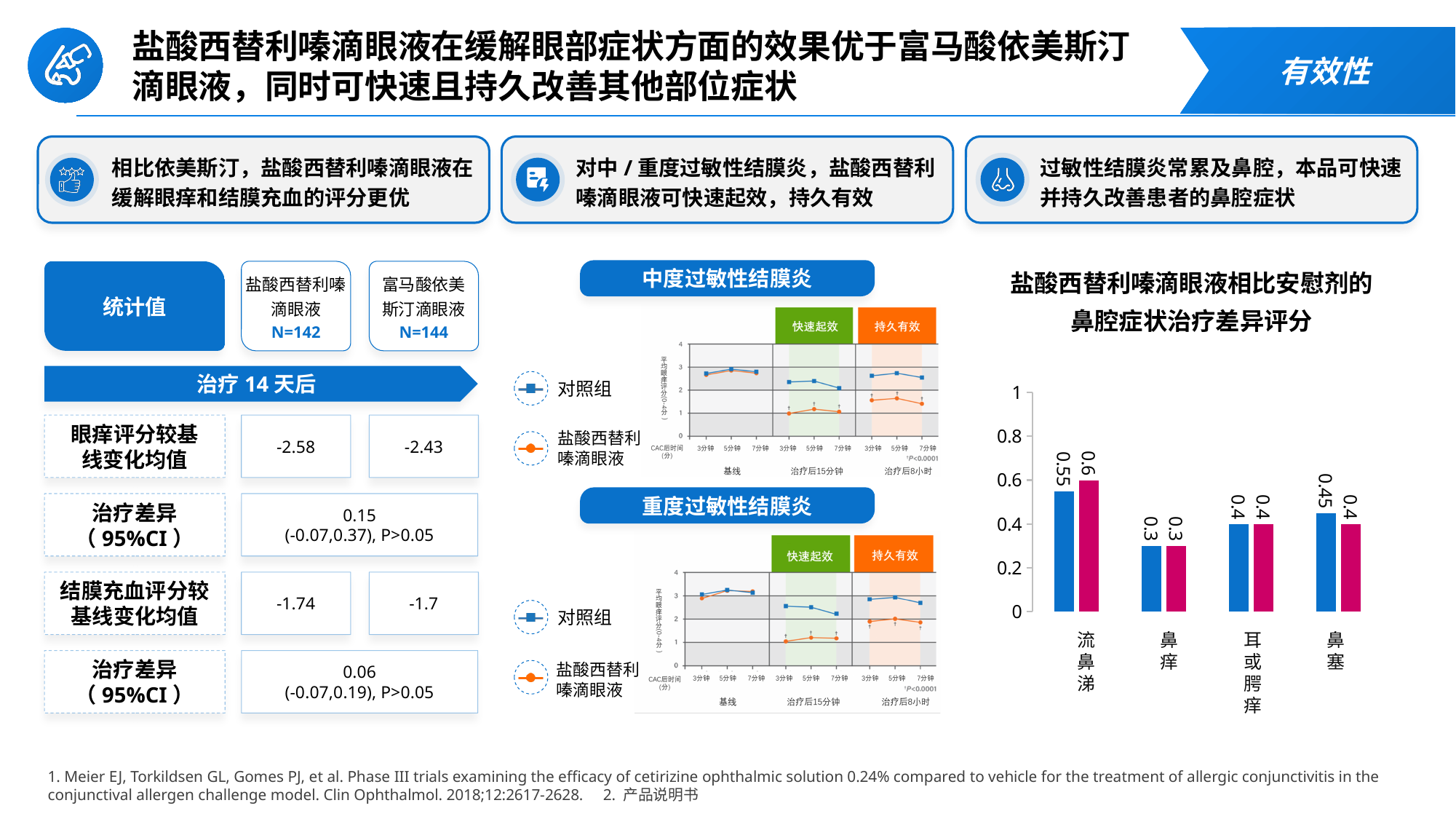
In the bar chart 盐酸西替利嗪滴眼液相比安慰剂的鼻腔症状治疗差异评分, what is the value of the blue bar for 流鼻涕? 0.55 In the bar chart 盐酸西替利嗪滴眼液相比安慰剂的鼻腔症状治疗差异评分, what is the value of the pink bar for 鼻痒? 0.3 In the bar chart 盐酸西替利嗪滴眼液相比安慰剂的鼻腔症状治疗差异评分, which is larger for 鼻塞, the blue bar or the pink bar? the blue bar In the bar chart 盐酸西替利嗪滴眼液相比安慰剂的鼻腔症状治疗差异评分, which category has the highest blue bar? 流鼻涕 In the bar chart 盐酸西替利嗪滴眼液相比安慰剂的鼻腔症状治疗差异评分, what is the value of the blue bar for 鼻塞? 0.45 In the bar chart 盐酸西替利嗪滴眼液相比安慰剂的鼻腔症状治疗差异评分, which category has the lowest pink bar? 鼻痒 In the bar chart 盐酸西替利嗪滴眼液相比安慰剂的鼻腔症状治疗差异评分, what is the value of the pink bar for 流鼻涕? 0.6 What kind of chart is the chart titled 盐酸西替利嗪滴眼液相比安慰剂的鼻腔症状治疗差异评分? bar chart In the bar chart 盐酸西替利嗪滴眼液相比安慰剂的鼻腔症状治疗差异评分, what is the difference between the pink bar and the blue bar for 流鼻涕? 0.05 What are the two legend entries of the line chart titled 重度过敏性结膜炎? 对照组 and 盐酸西替利嗪滴眼液 How many series does the legend list for the line chart titled 中度过敏性结膜炎? 2 How many categories are shown on the x axis of the bar chart 盐酸西替利嗪滴眼液相比安慰剂的鼻腔症状治疗差异评分? 4